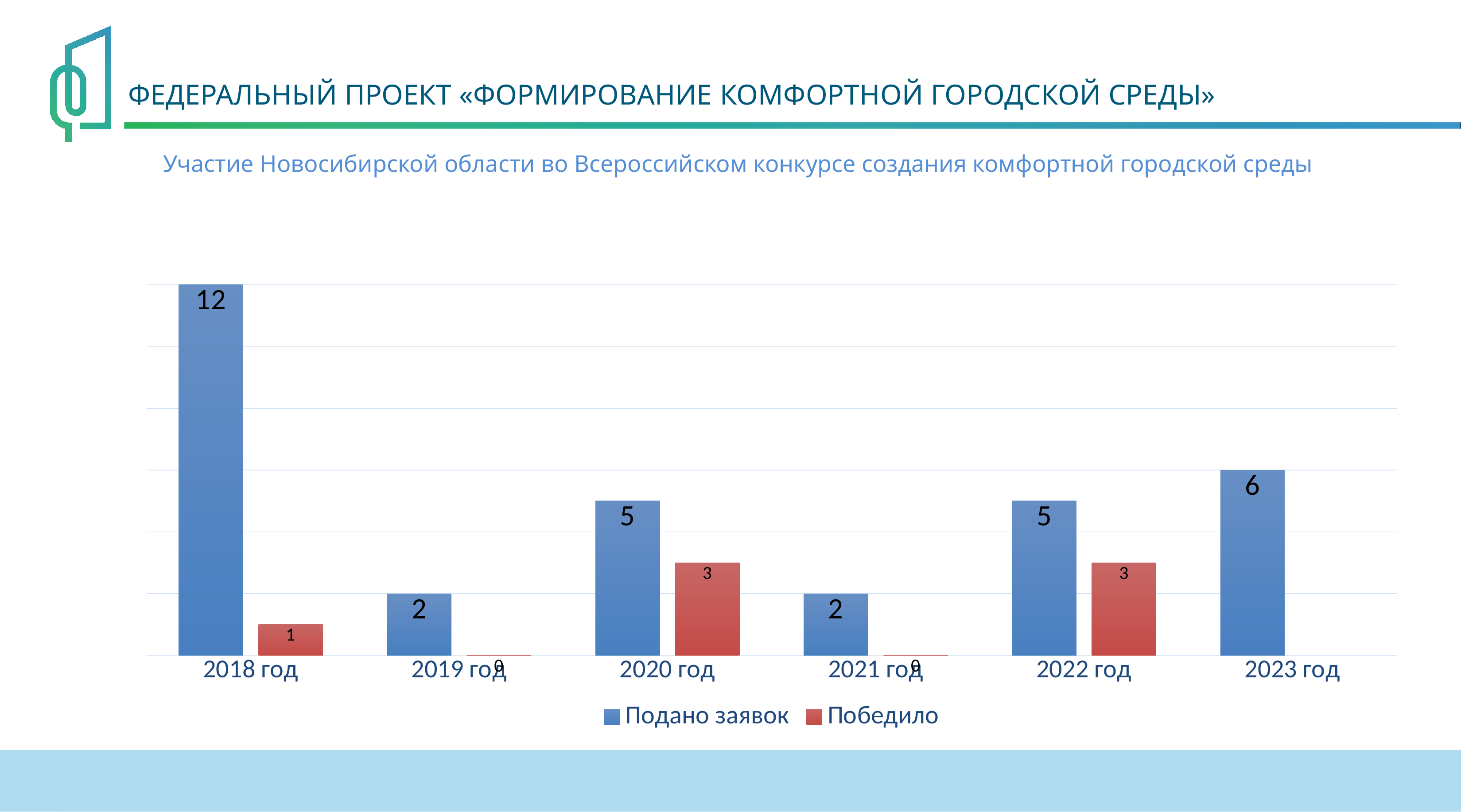
Which is larger: "Подано заявок" for 2020 год or for 2023 год? 2023 год Which year has the highest value for "Подано заявок"? 2018 год What is the value of "Победило" for 2020 год? 3 How many years are shown on the x axis? 6 What kind of chart is shown on the slide? Bar chart What colour represents the "Победило" series? Red How many series does the legend list? 2 What is the value of "Подано заявок" for 2018 год? 12 What is the value of "Победило" for 2018 год? 1 What is the difference in "Подано заявок" between 2018 год and 2023 год? 6 What is the difference between "Подано заявок" and "Победило" for 2022 год? 2 What is the value of "Подано заявок" for 2023 год? 6